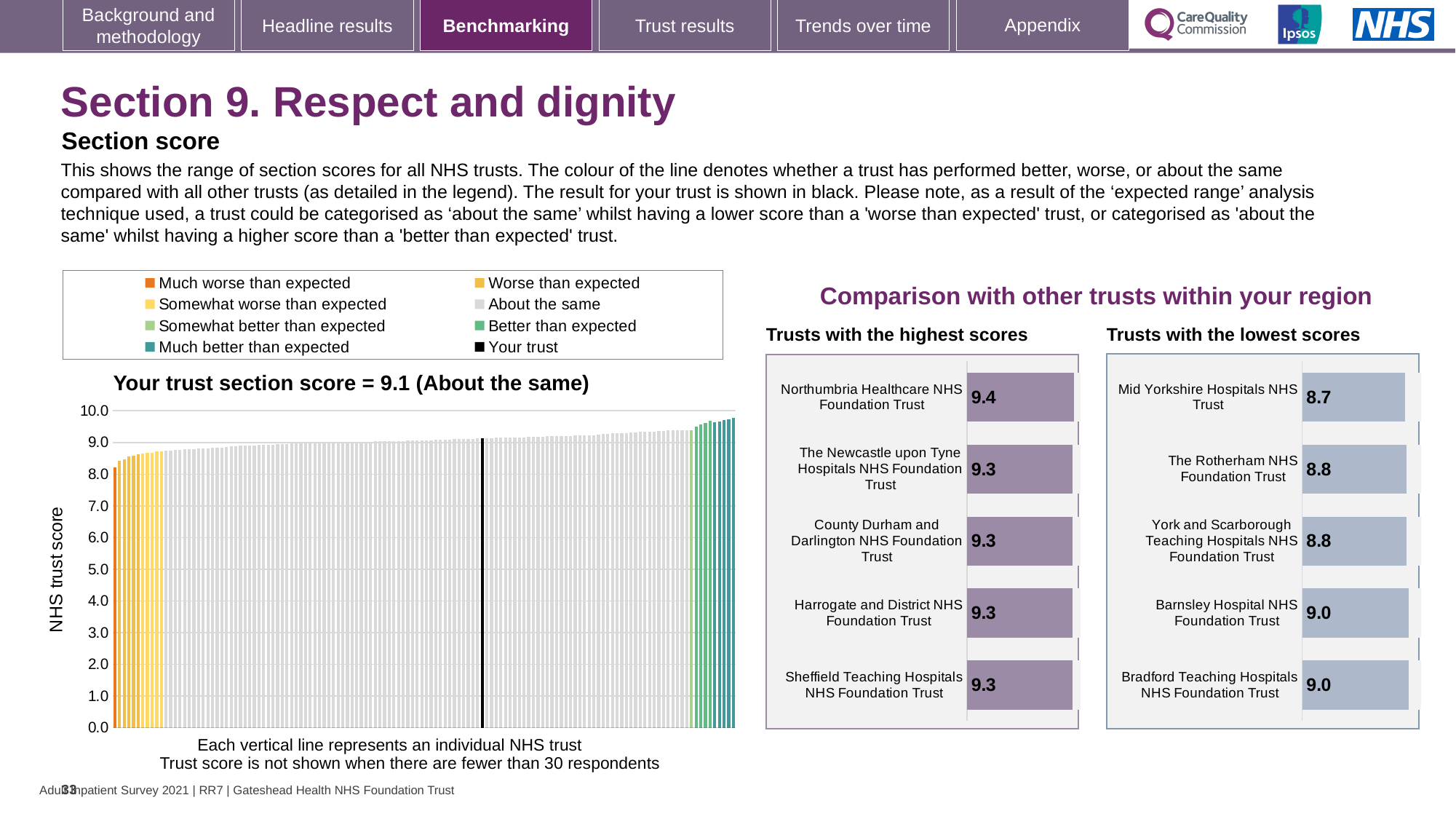
In the 'Trusts with the highest scores' chart, what is the score for Northumbria Healthcare NHS Foundation Trust? 9.4 In the 'Trusts with the highest scores' chart, which trust has the highest score? Northumbria Healthcare NHS Foundation Trust In the 'Your trust section score' chart, do the bar heights rise or fall from left to right along the x axis? rise In the 'Trusts with the lowest scores' chart, which trust has the lowest score? Mid Yorkshire Hospitals NHS Trust In the 'Trusts with the lowest scores' chart, which has the larger score: Barnsley Hospital NHS Foundation Trust or The Rotherham NHS Foundation Trust? Barnsley Hospital NHS Foundation Trust In the 'Your trust section score' chart, what is the section score for your trust, as stated in the chart title? 9.1 In the 'Your trust section score' chart, is the value of the leftmost bar greater or less than 9.0? less How many trusts are shown in the 'Trusts with the lowest scores' chart? 5 In the 'Your trust section score' chart, is the value of the rightmost bar greater or less than 9.0? greater What kind of chart is the 'Your trust section score' chart on the left of the slide? bar chart How many entries does the legend above the 'Your trust section score' chart list? 8 In the 'Trusts with the lowest scores' chart, what is the difference between the scores of Bradford Teaching Hospitals NHS Foundation Trust and Mid Yorkshire Hospitals NHS Trust? 0.3